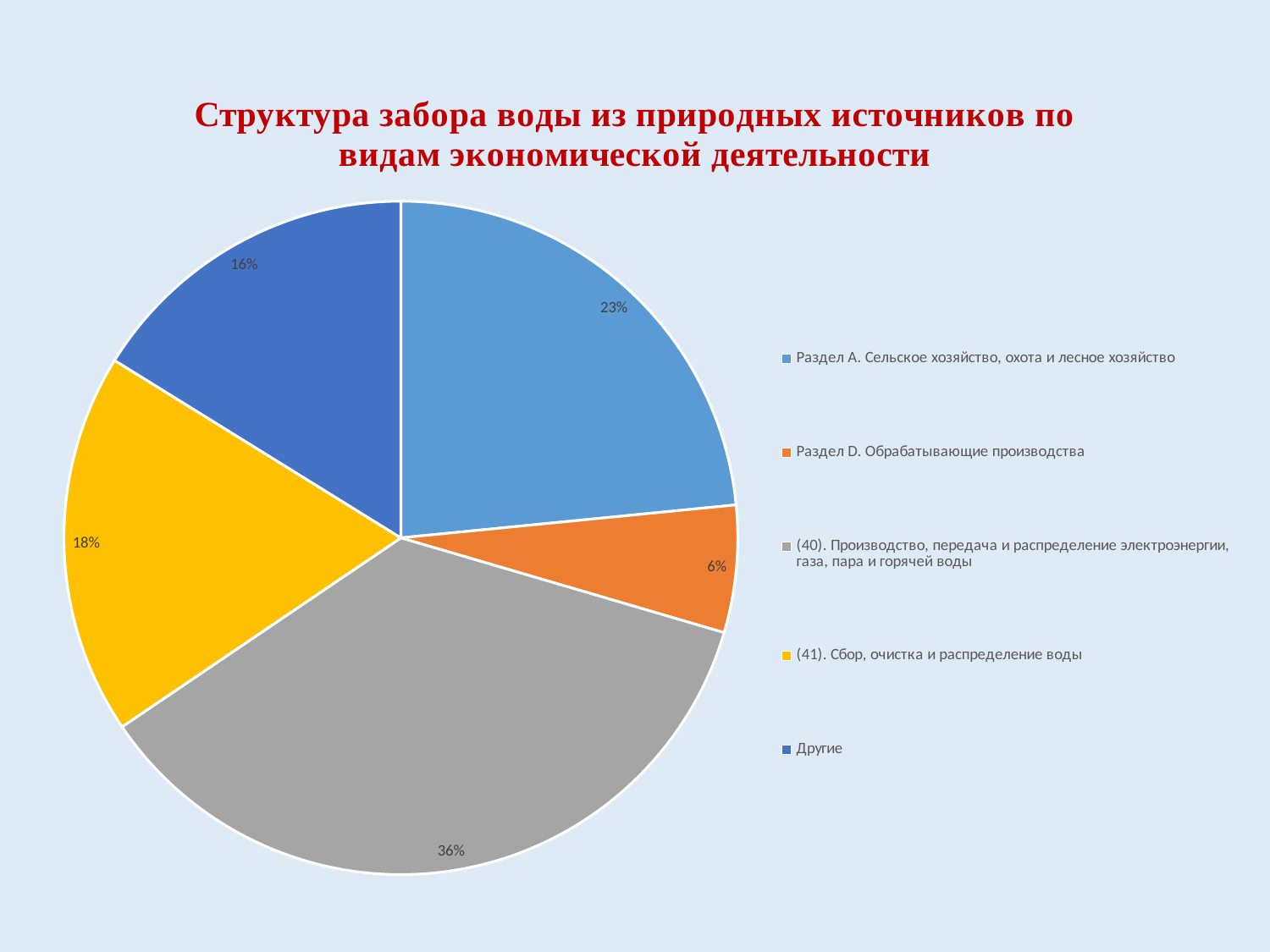
What is the difference in percentage points between the share of "(40). Производство, передача и распределение электроэнергии, газа, пара и горячей воды" and "Раздел A. Сельское хозяйство, охота и лесное хозяйство"? 13 What colour is the slice for "Другие"? Blue Which category has the smallest slice of the pie? Раздел D. Обрабатывающие производства What kind of chart is shown on the slide? Pie chart Which category has the largest slice of the pie? (40). Производство, передача и распределение электроэнергии, газа, пара и горячей воды What share of the pie does "(40). Производство, передача и распределение электроэнергии, газа, пара и горячей воды" have? 36% Which is larger: the share of "(41). Сбор, очистка и распределение воды" or the share of "Другие"? (41). Сбор, очистка и распределение воды What share of the pie does "Раздел D. Обрабатывающие производства" have? 6% What share of the pie does "Другие" have? 16% How many categories does the pie chart show? 5